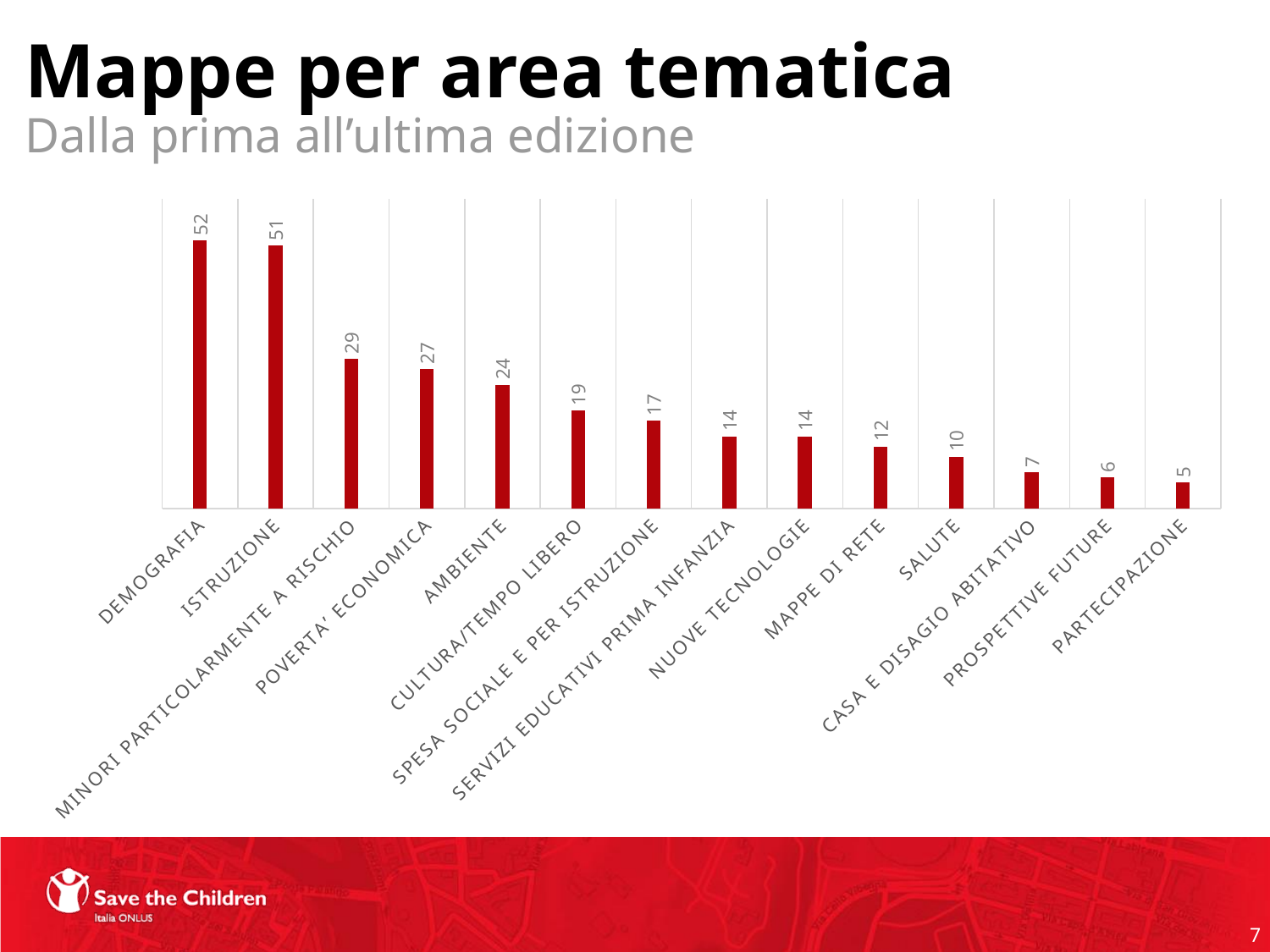
What kind of chart is shown on the slide? Bar chart Which category has the lowest value? PARTECIPAZIONE Which is larger, the value for MAPPE DI RETE or the value for SALUTE? MAPPE DI RETE What is the value for SALUTE? 10 What is the difference between the values for MINORI PARTICOLARMENTE A RISCHIO and POVERTA' ECONOMICA? 2 What is the value for CULTURA/TEMPO LIBERO? 19 Which category has the highest value? DEMOGRAFIA What is the title of the slide containing the chart? Mappe per area tematica What is the value for AMBIENTE? 24 How many categories are shown in the chart? 14 What is the difference between the values for DEMOGRAFIA and ISTRUZIONE? 1 What is the value for DEMOGRAFIA? 52